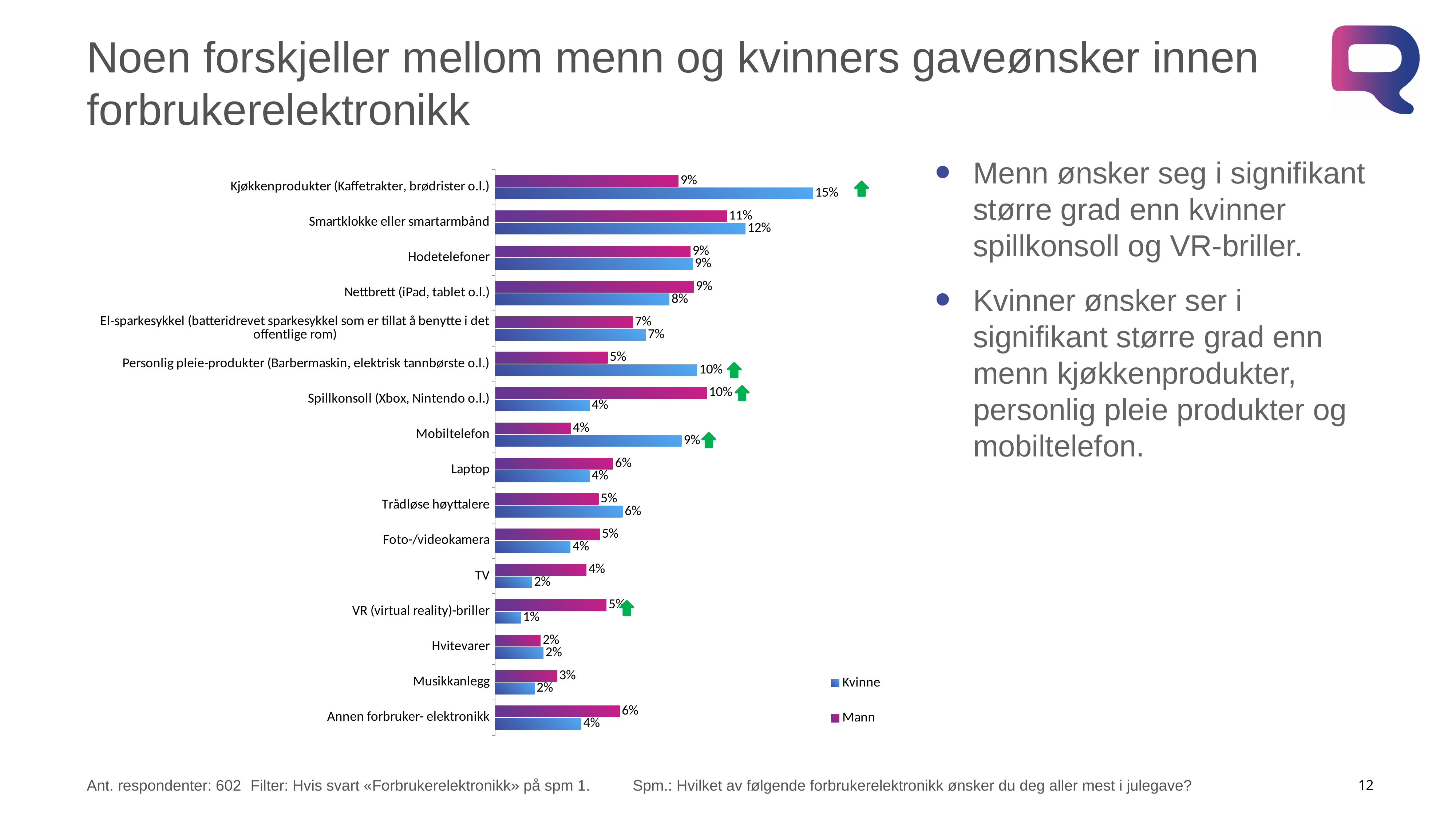
What kind of chart is shown on the slide? Bar chart For Mobiltelefon, which series has the larger value, Kvinne or Mann? Kvinne What is the Mann value for Spillkonsoll (Xbox, Nintendo o.l.)? 10% What is the difference between the Mann and Kvinne values for Spillkonsoll (Xbox, Nintendo o.l.)? 6% How many series does the legend list? 2 What is the Kvinne value for VR (virtual reality)-briller? 1% What is the difference between the Kvinne and Mann values for Kjøkkenprodukter (Kaffetrakter, brødrister o.l.)? 6% How many categories are shown in the chart? 16 What is the Kvinne value for Kjøkkenprodukter (Kaffetrakter, brødrister o.l.)? 15% Which category has the highest Kvinne value? Kjøkkenprodukter (Kaffetrakter, brødrister o.l.) Which category has the lowest Kvinne value? VR (virtual reality)-briller Which category has the highest Mann value? Smartklokke eller smartarmbånd